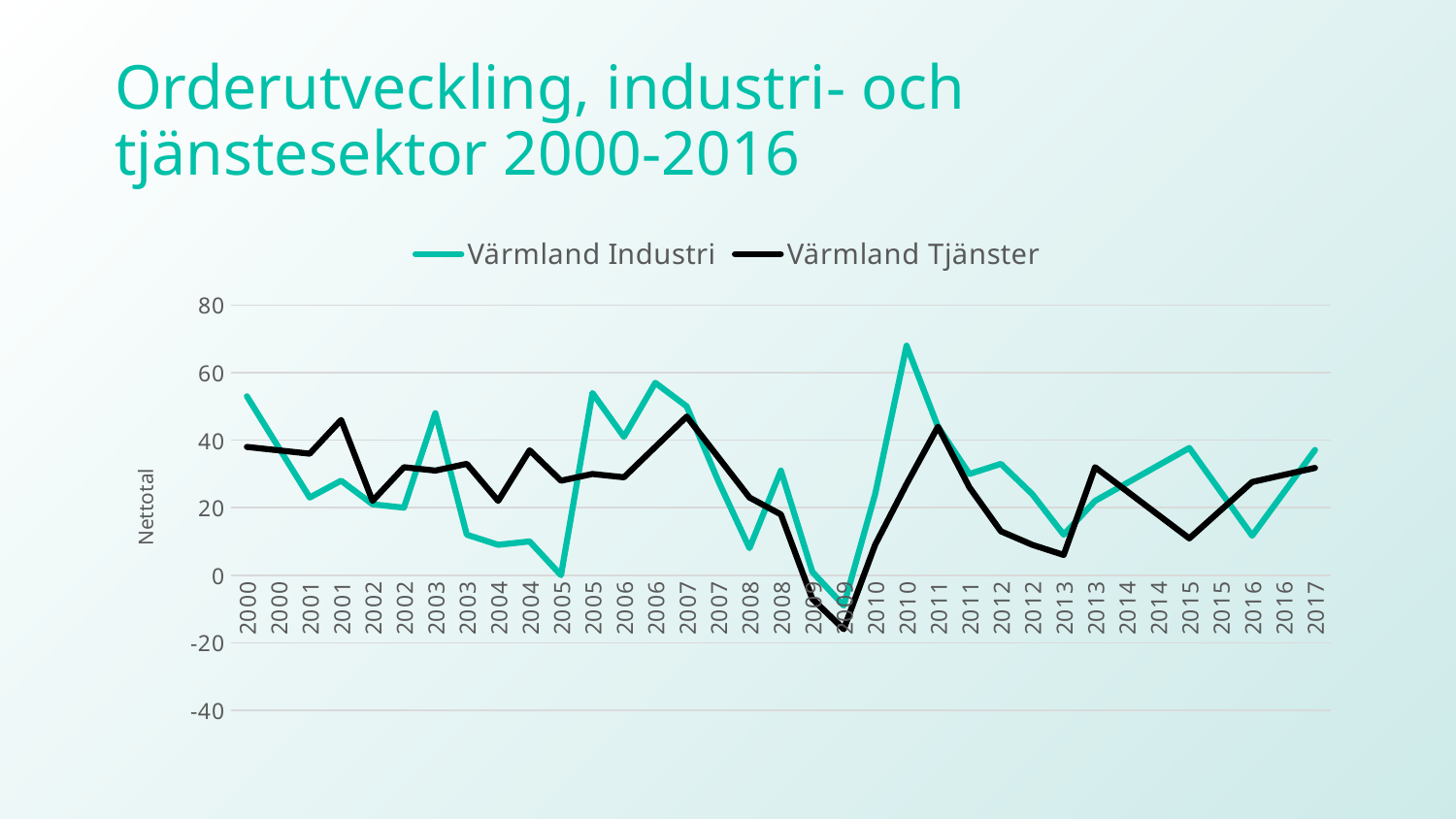
Is the peak value for Värmland Industri in 2010 greater or less than 60? greater Is the lowest value for Värmland Tjänster in 2009 greater or less than 0? less In which year does Värmland Tjänster reach its lowest value? 2009 How many series does the legend list? 2 What are the two series named in the legend? Värmland Industri and Värmland Tjänster What kind of chart is shown on the slide? line chart At the first 2005 point, which series has the larger value, Värmland Industri or Värmland Tjänster? Värmland Tjänster At the 2010 peak, which series has the larger value, Värmland Industri or Värmland Tjänster? Värmland Industri What is the label on the vertical axis? Nettotal Is the first 2000 value for Värmland Industri greater or less than 40? greater Which series reaches the highest value anywhere on the chart? Värmland Industri In which year does Värmland Industri reach its highest value? 2010